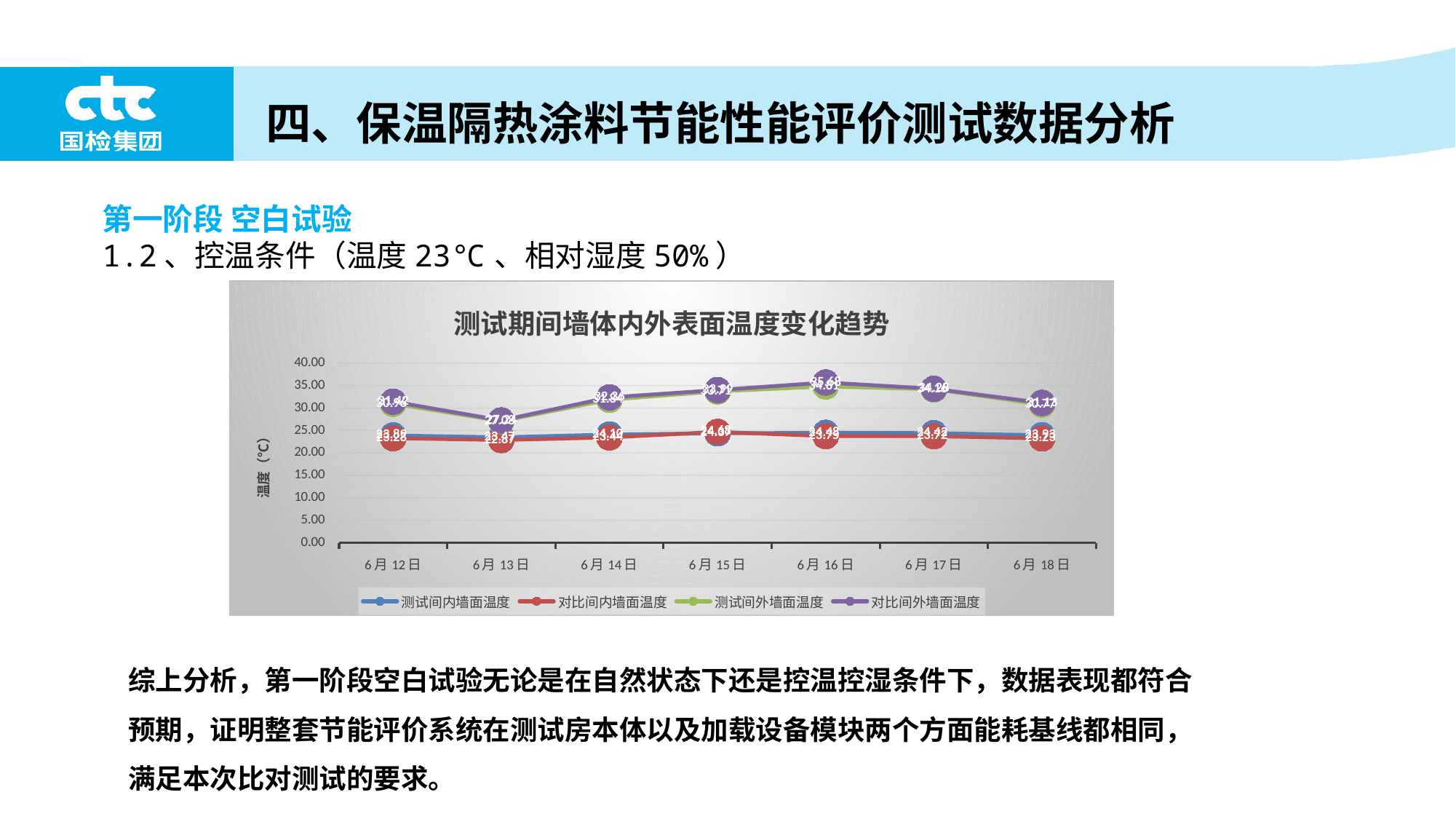
Is the value for 对比间外墙面温度 on 6月13日 greater or less than 30.00? less On which date is the 对比间外墙面温度 series at its lowest? 6月13日 On 6月14日, which is larger: 测试间外墙面温度 or 测试间内墙面温度? 测试间外墙面温度 On which date is the 对比间外墙面温度 series at its highest? 6月16日 How many dates are plotted along the x axis of the chart? 7 What is the title of the chart? 测试期间墙体内外表面温度变化趋势 How many series does the chart legend list? 4 What is the label of the y axis of the chart? 温度（℃） Is the value for 对比间外墙面温度 on 6月16日 greater or less than 35.00? greater Does the 对比间外墙面温度 series rise or fall from 6月13日 to 6月16日? rise Is the value for 对比间内墙面温度 on 6月15日 greater or less than 20.00? greater What kind of chart is shown on the slide? line chart